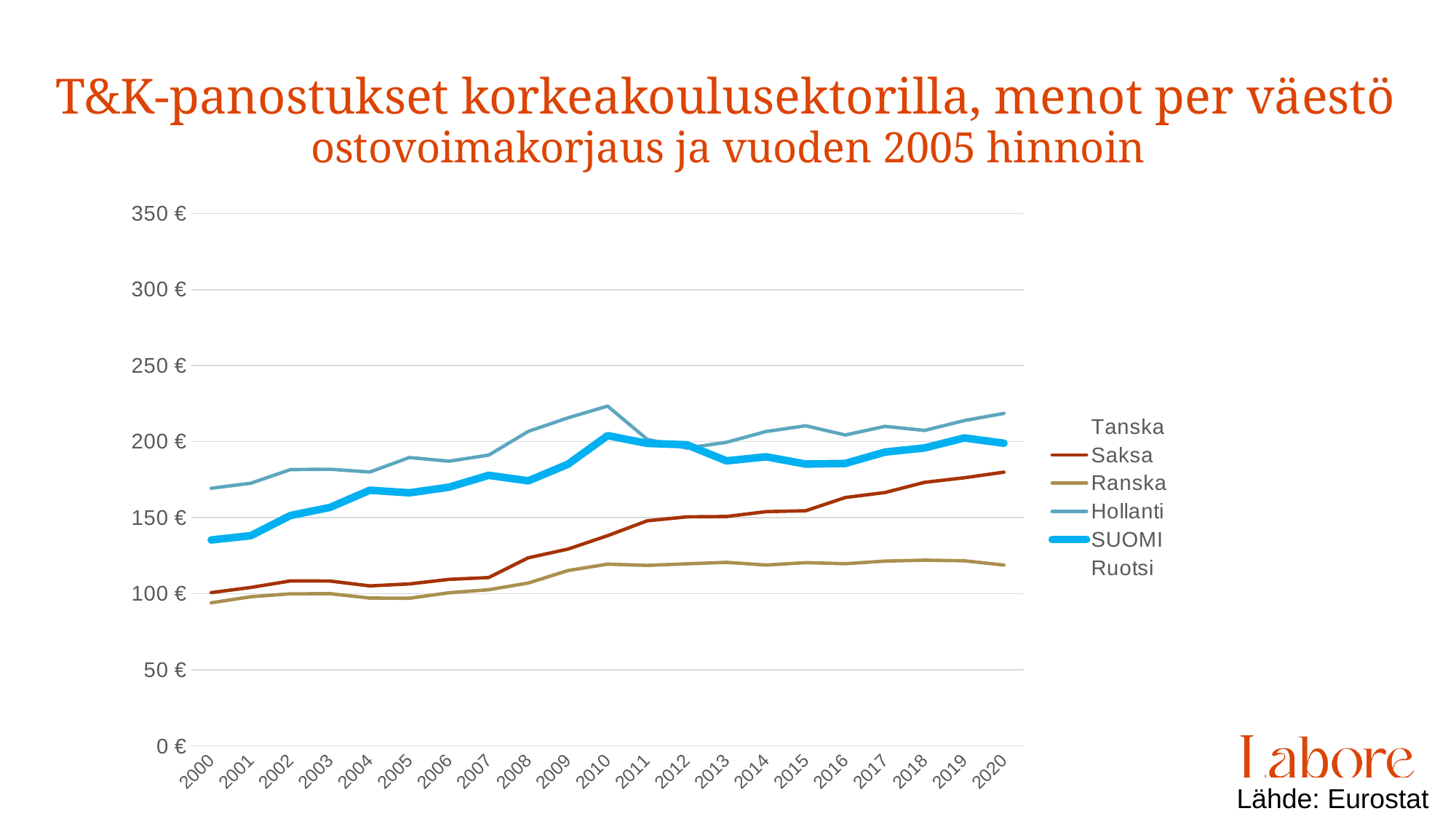
Is the value for Saksa in 2020 greater or less than 200 €? less Is the value for Hollanti in 2010 greater or less than 200 €? greater How many years are shown on the x axis? 21 Is the value for SUOMI in 2000 greater or less than 150 €? less Does the value for Saksa rise or fall from 2000 to 2020? rise Which series has the highest value in 2020? Hollanti Which series is drawn with the thickest line? SUOMI In 2010, which is larger, the value for Hollanti or the value for Saksa? Hollanti What kind of chart is shown on the slide? line chart How many series does the legend list? 6 Which series has the lowest value in 2020? Ranska